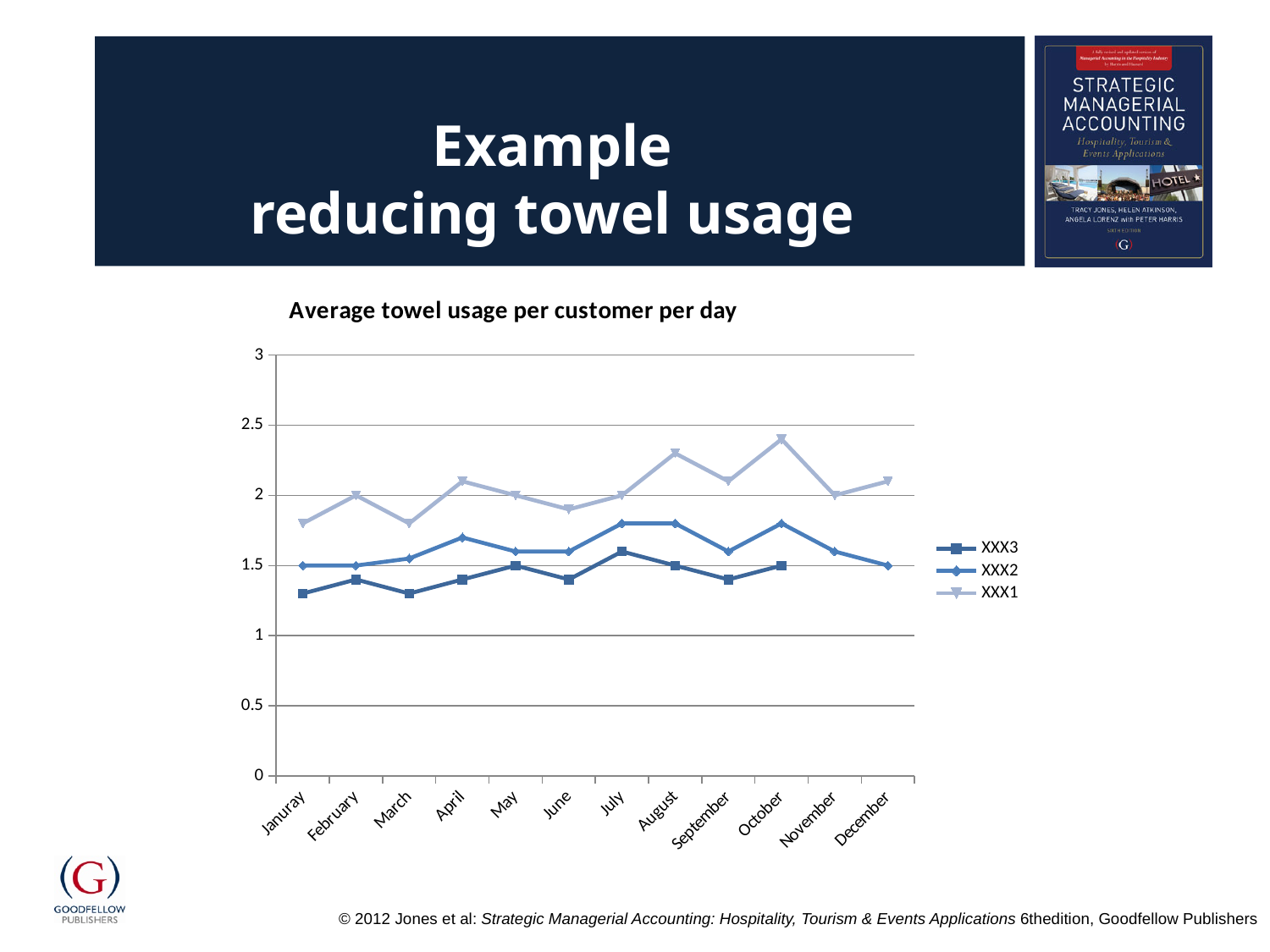
Is the value for XXX1 in October greater or less than 2? greater What is the value of XXX2 in January? 1.5 In which month does XXX1 reach its highest value? October Is the value for XXX3 in January greater or less than 1.5? less What is the title of the chart? Average towel usage per customer per day What type of chart is shown on the slide? line chart Which series has the highest values throughout the year? XXX1 How many series does the legend list? 3 How many months are shown along the x axis? 12 What is the value of XXX1 in February? 2 Does the XXX1 line rise or fall from August to September? fall In August, which series has the larger value, XXX1 or XXX3? XXX1